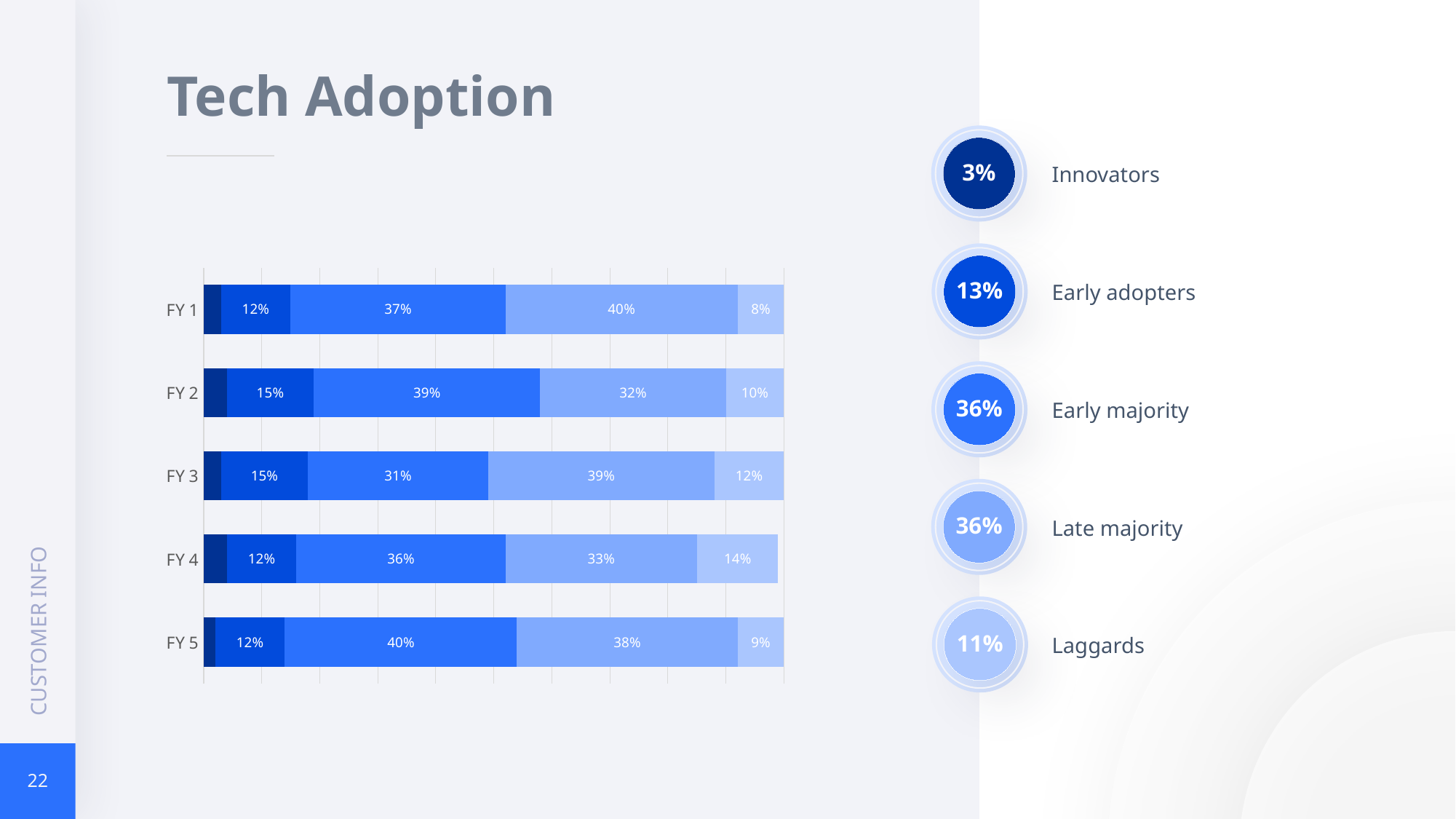
Which fiscal year has the highest value for the fourth segment from the left (the light blue segment)? FY 1 What is the value of the third segment from the left in the FY 2 bar? 39% Which fiscal year has the highest value for the third segment from the left? FY 5 What kind of chart is shown on the slide? Stacked bar chart How many fiscal years (categories) are plotted in the chart? 5 What is the title of the slide containing the chart? Tech Adoption What is the value of the fourth segment from the left in the FY 5 bar? 38% Which fiscal year has the lowest value for the rightmost segment? FY 1 Which is larger: the rightmost segment of FY 3 or the rightmost segment of FY 5? FY 3 What is the value of the rightmost segment in the FY 4 bar? 14% What is the difference between the third-segment values of FY 2 and FY 3? 8% What is the value of the second segment from the left in the FY 1 bar? 12%